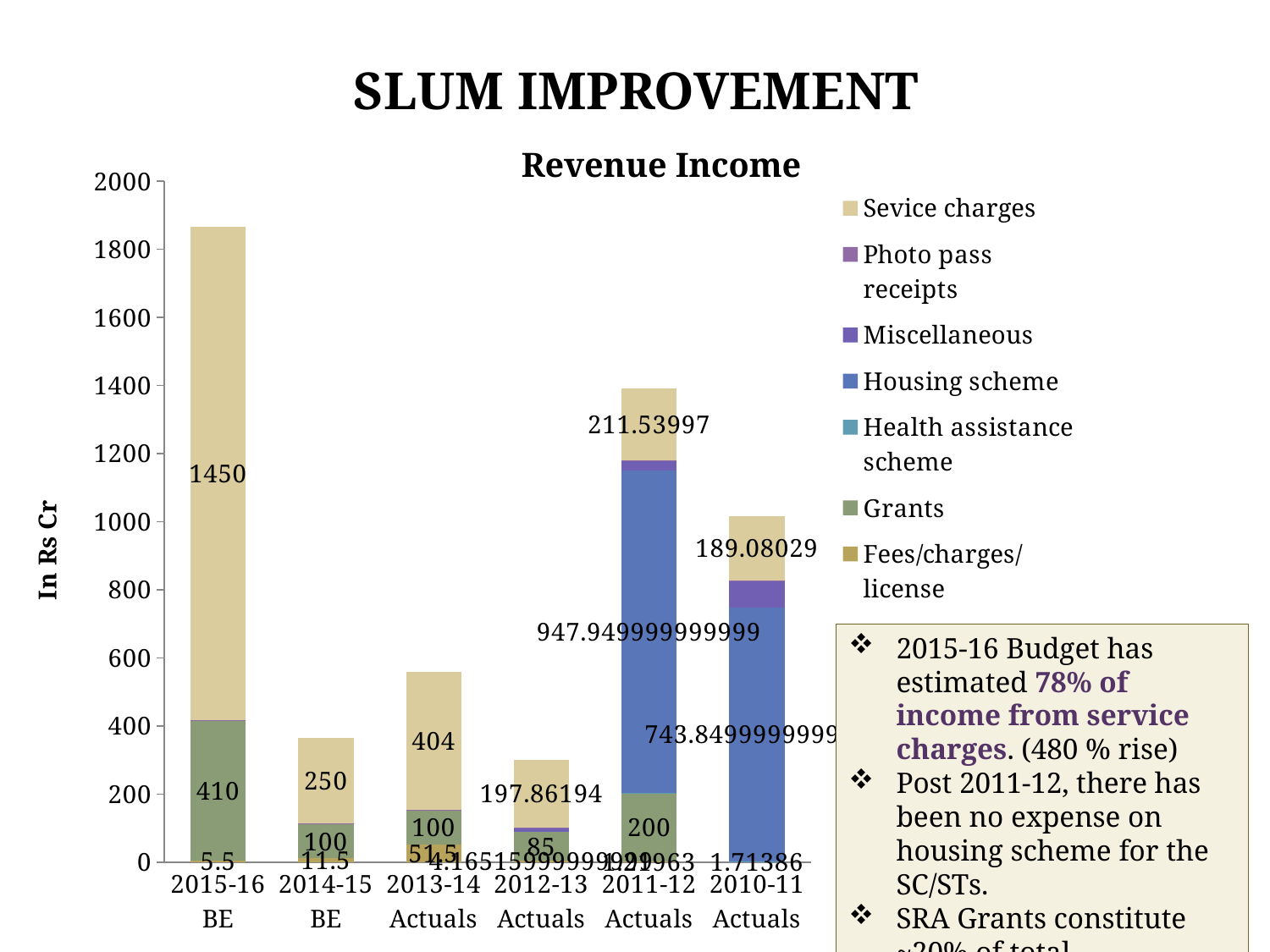
How many categories are shown on the x axis of the Revenue Income chart? 6 What is the value of Sevice charges for 2010-11 Actuals? 189.08029 What is the difference between Sevice charges for 2015-16 BE and 2014-15 BE? 1200 What is the value of Sevice charges for 2013-14 Actuals? 404 What is the title of the y axis of the chart? In Rs Cr What is the value of Grants for 2015-16 BE? 410 How many series does the legend of the Revenue Income chart list? 7 Which category has the tallest total bar in the Revenue Income chart? 2015-16 BE What is the value of Sevice charges for 2015-16 BE? 1450 Is the total bar for 2015-16 BE greater or less than 1800? greater What is the value of Housing scheme for 2011-12 Actuals? 947.949999999999 What kind of chart is shown on the slide? Stacked bar chart